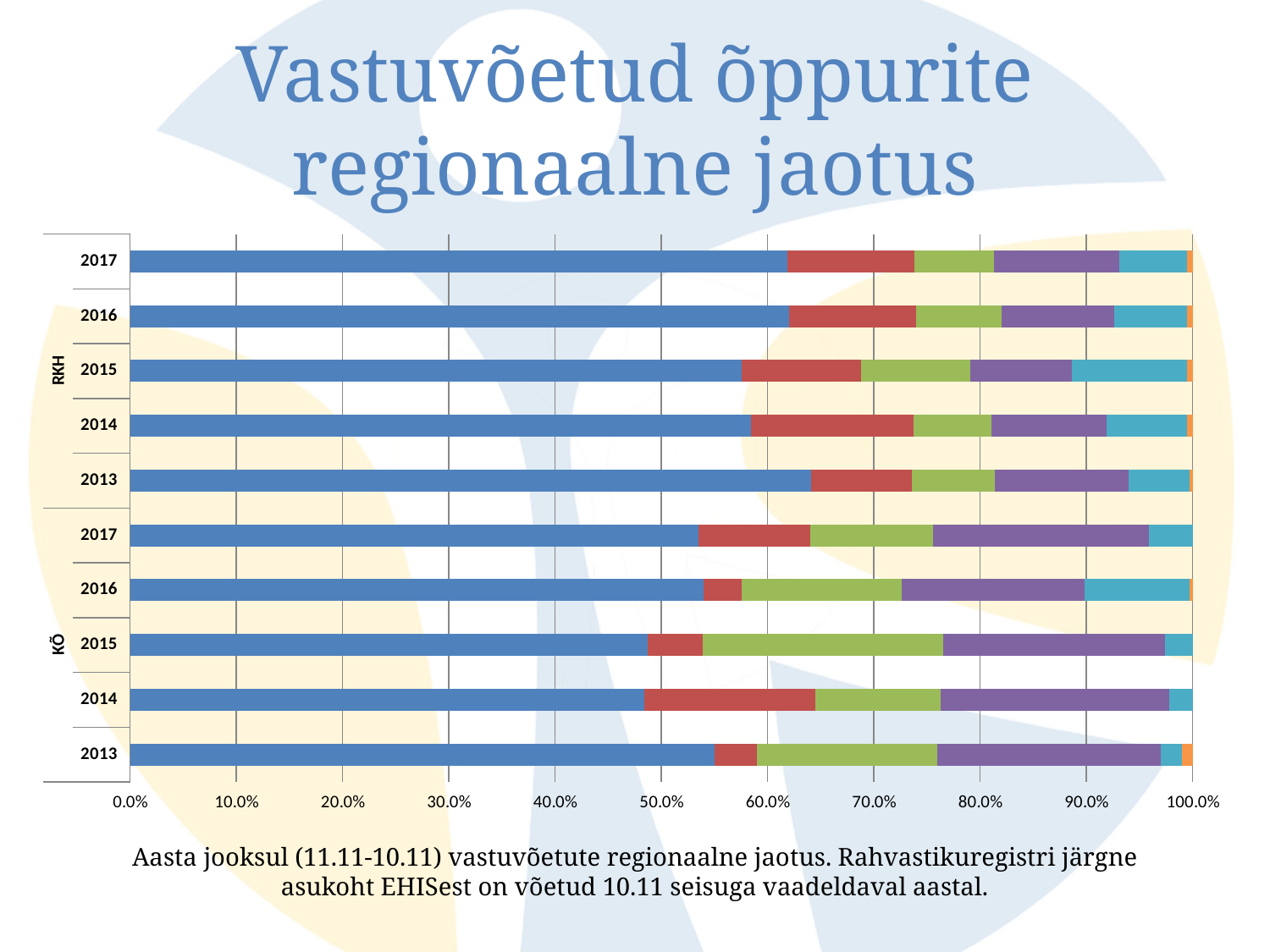
Is the blue segment for RKH 2015 greater or less than 60.0%? less What kind of chart is shown on the slide? Stacked bar chart What is the title of the chart on the slide? Vastuvõetud õppurite regionaalne jaotus Is the blue segment for KÕ 2013 greater or less than 50.0%? greater Which has the longer blue segment, RKH 2017 or KÕ 2017? RKH 2017 Is the blue segment for RKH 2013 greater or less than 60.0%? greater How many bars (year rows) are plotted in the chart? 10 Which has the longer blue segment, RKH 2014 or KÕ 2014? RKH 2014 What are the two group labels shown on the vertical axis of the chart? RKH and KÕ